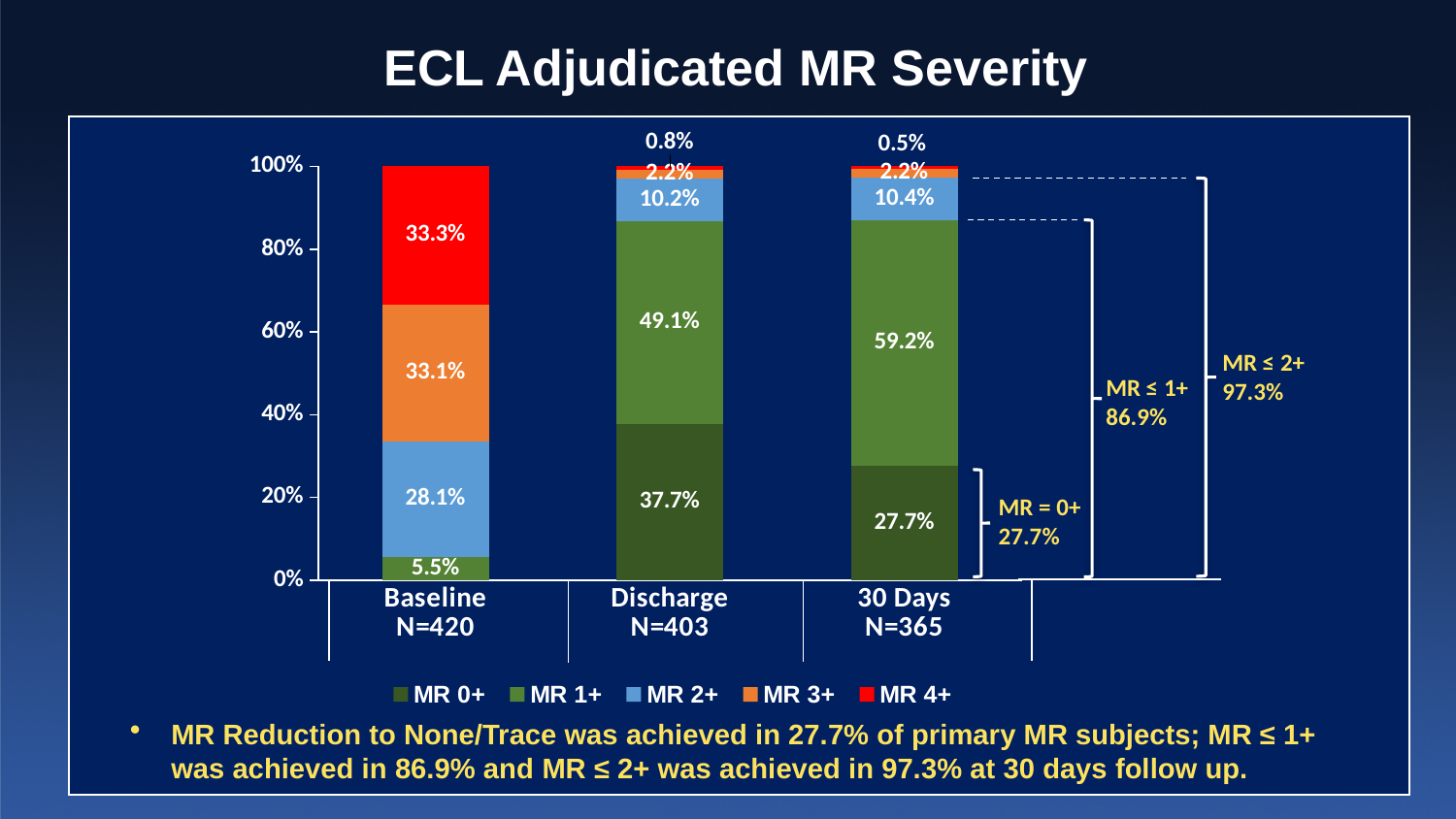
How many categories are shown on the x axis? 3 What is the value of the MR 4+ segment for Baseline? 33.3% What is the value of the MR 1+ segment for Discharge? 49.1% What is the value of the MR 0+ segment for 30 Days? 27.7% Which category has the largest MR 1+ segment? 30 Days Is the MR 0+ segment larger for Discharge or for 30 Days? Discharge What is the sample size (N) shown for the Discharge category? N=403 How many series does the legend list? 5 What is the value of the MR 4+ segment for 30 Days? 0.5% What kind of chart is shown on the slide? Stacked bar chart What is the difference between the MR 1+ values for 30 Days and Discharge? 10.1% Which category has the smallest MR 0+ segment? Baseline